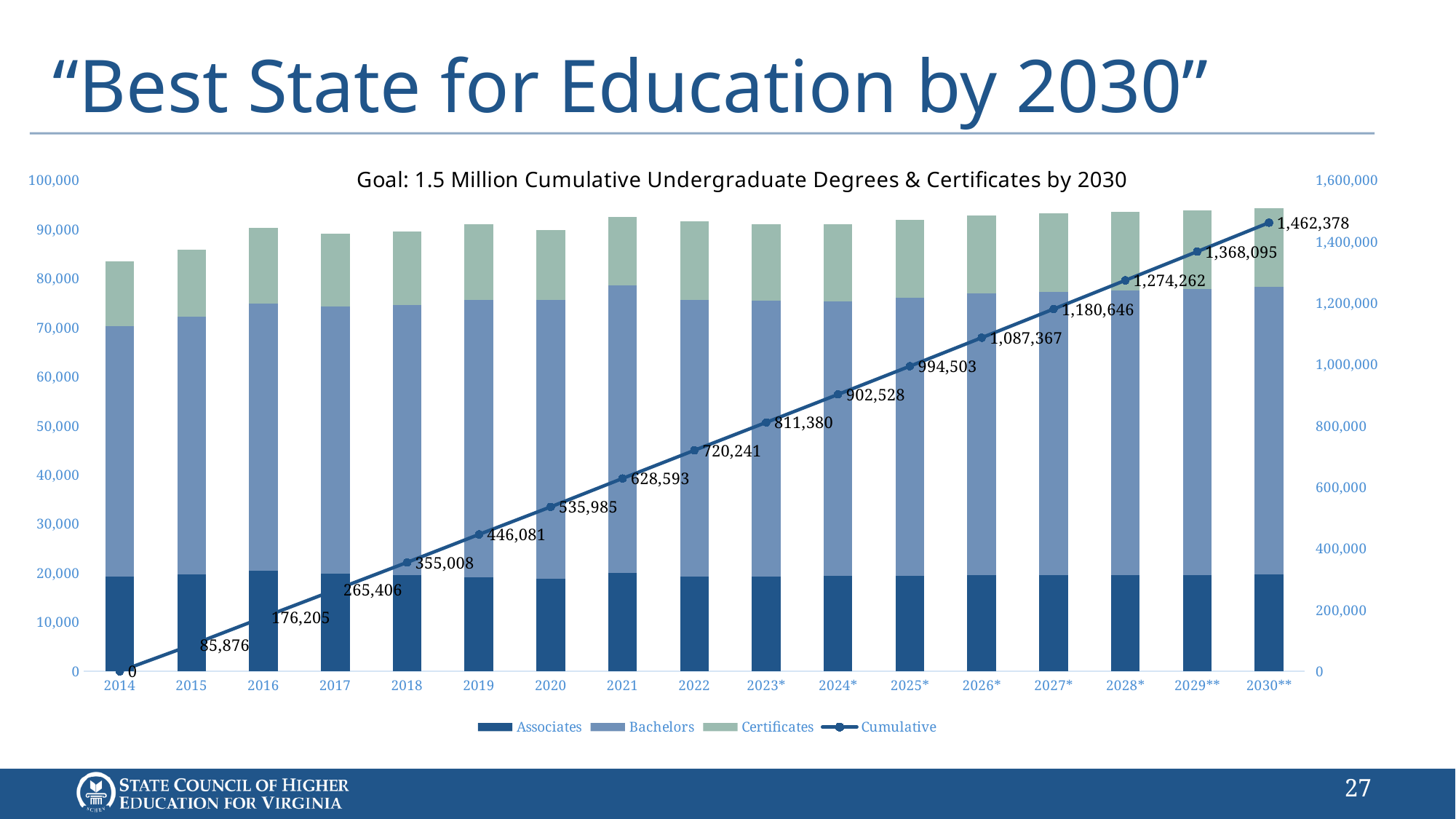
Does the Cumulative line rise or fall from 2014 to 2030**? rises What is the Cumulative value for 2018? 355,008 What is the Cumulative value for 2025*? 994,503 Which year has the highest Cumulative value? 2030** Which is larger, the Cumulative value for 2019 or for 2023*? 2023* What is the Cumulative value for 2030**? 1,462,378 Which year has the lowest Cumulative value? 2014 Is the total height of the stacked bar for 2014 greater or less than 90,000? less What is the Cumulative value for 2022? 720,241 How many series does the legend list? 4 How many years are shown on the x axis? 17 What is the difference between the Cumulative values for 2030** and 2029**? 94,283